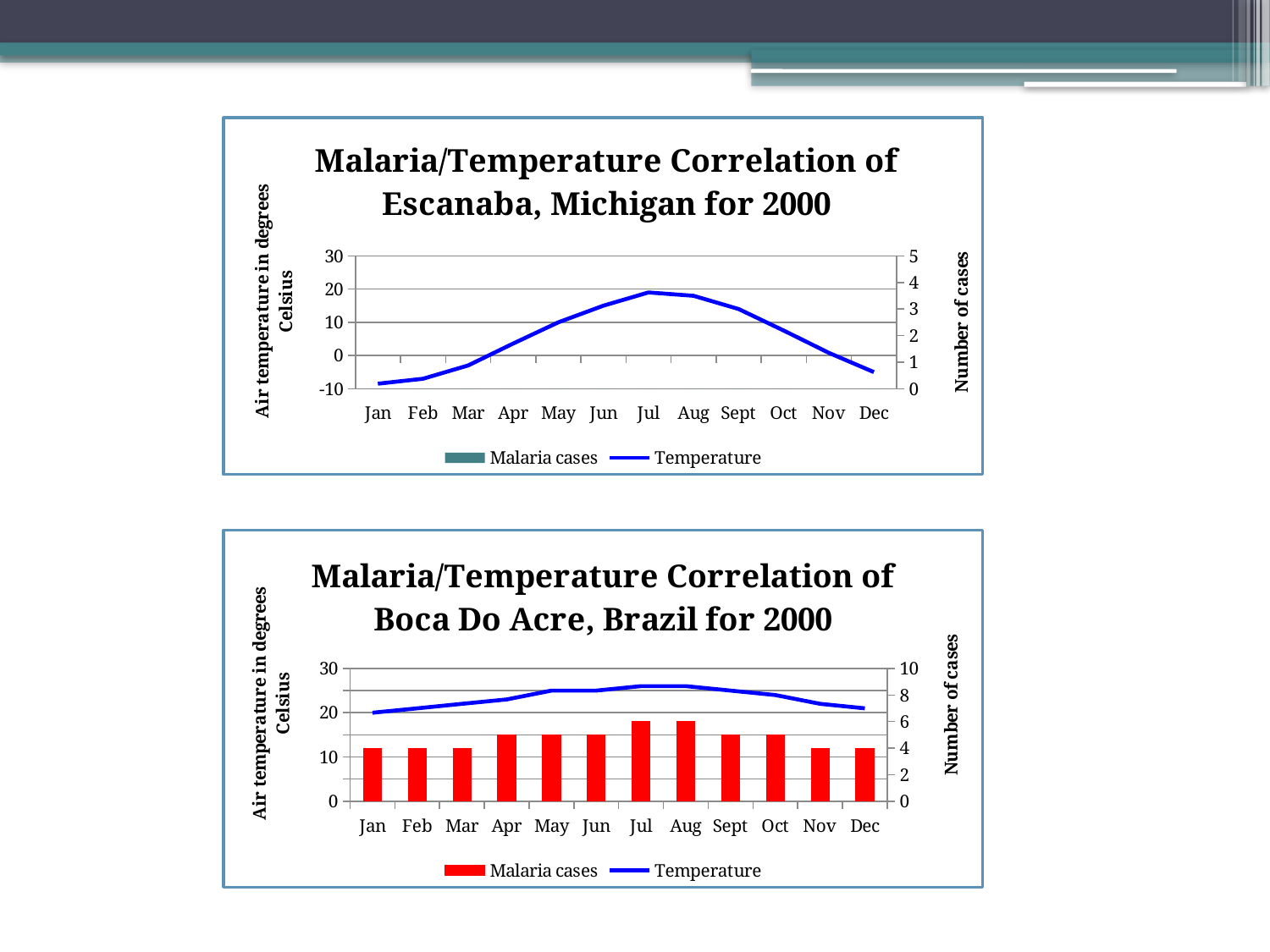
In the Boca Do Acre, Brazil chart, what kind of chart is used for the Malaria cases series? bar chart In the Boca Do Acre, Brazil chart, how many series does the legend list? 2 In the Boca Do Acre, Brazil chart, which is larger, the number of malaria cases in Jul or in Jan? Jul In the Escanaba, Michigan chart, which month has the lowest temperature? Jan In the Escanaba, Michigan chart, which month has the highest temperature? Jul In the Boca Do Acre, Brazil chart, is the temperature for Jul greater or less than 20? greater In the Escanaba, Michigan chart, how many series does the legend list? 2 In the Escanaba, Michigan chart, is the temperature for Jan greater or less than 0? less In the Escanaba, Michigan chart, how many months are shown on the x axis? 12 In the Escanaba, Michigan chart, is the temperature for Jul greater or less than 10? greater In the Boca Do Acre, Brazil chart, what colour are the Malaria cases bars? red In the Escanaba, Michigan chart, does the temperature rise or fall from Jan to Jul? rise